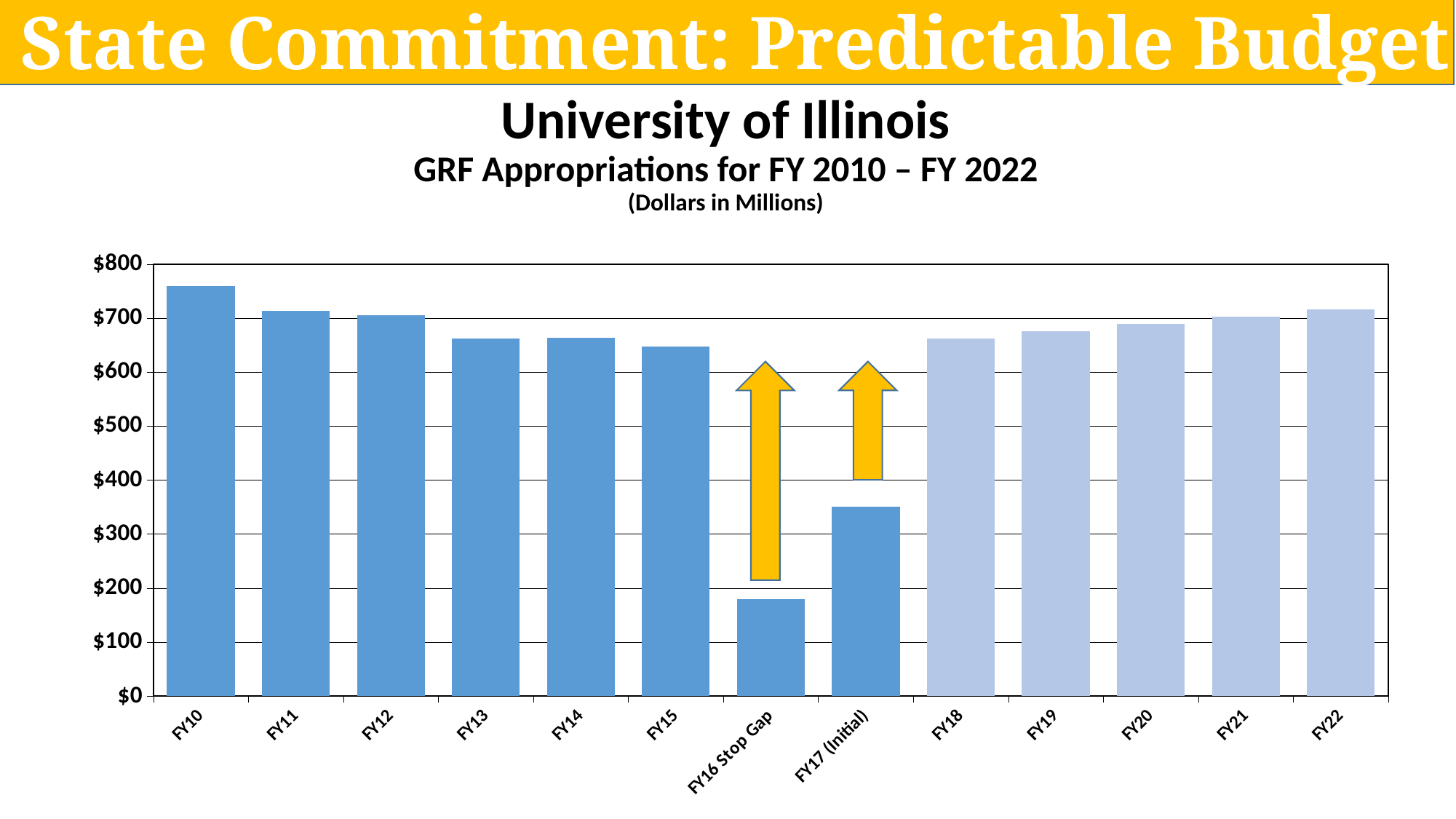
Which fiscal year has the highest GRF appropriation? FY10 Is the value for FY17 (Initial) greater or less than $300? greater Is the value for FY10 greater or less than $700? greater What kind of chart is shown on the slide? Bar chart Do the values rise or fall from FY18 to FY22? rise Which fiscal year has the lowest GRF appropriation? FY16 Stop Gap Which is larger, the value for FY10 or the value for FY15? FY10 What unit are the dollar values in, according to the chart subtitle? Dollars in Millions Which is larger, the value for FY16 Stop Gap or the value for FY17 (Initial)? FY17 (Initial) Is the value for FY16 Stop Gap greater or less than $200? less How many fiscal-year categories are plotted on the x axis? 13